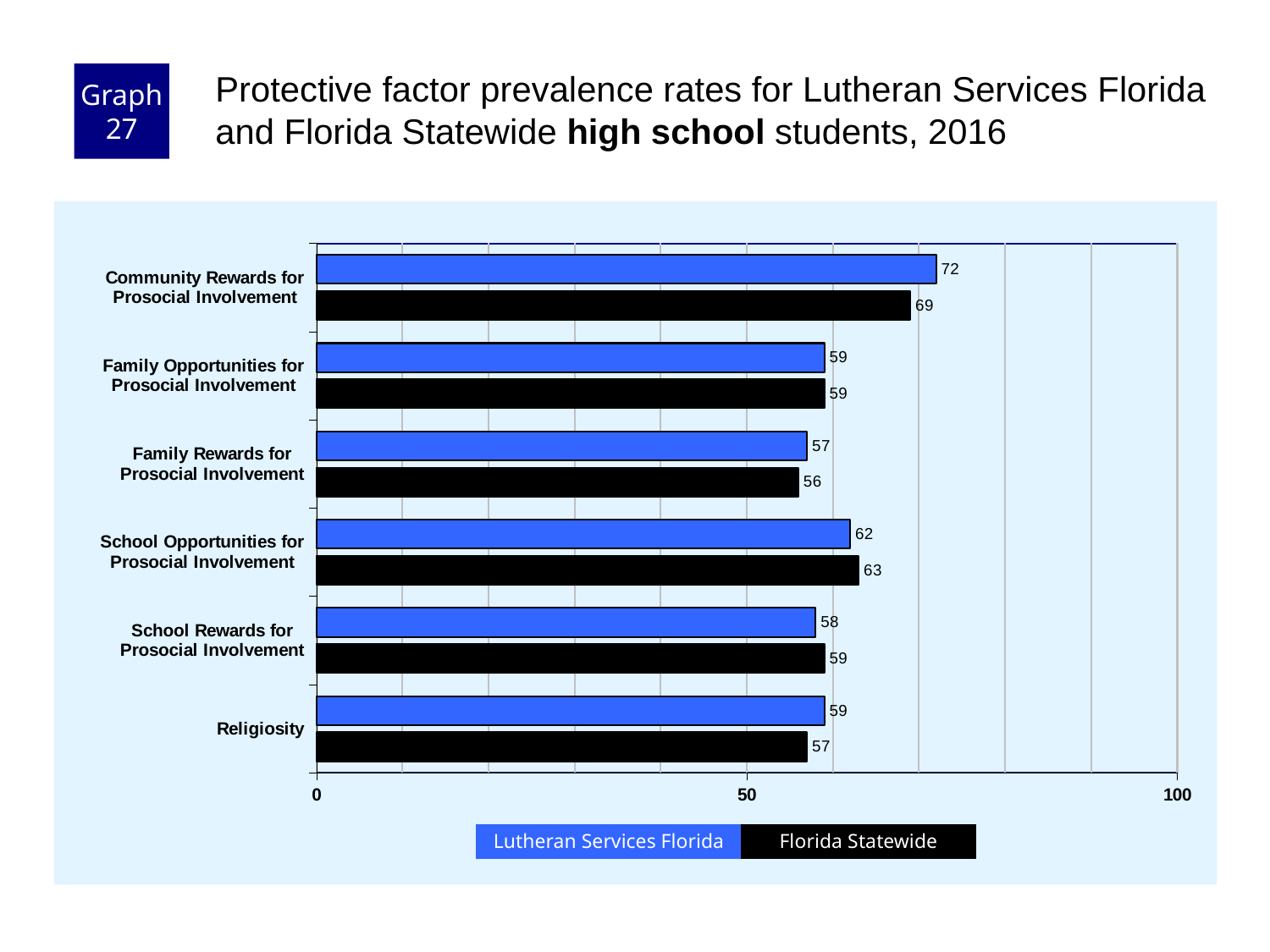
What is the Florida Statewide value for School Opportunities for Prosocial Involvement? 63 Which category has the lowest Florida Statewide value? Family Rewards for Prosocial Involvement What is the difference between the Lutheran Services Florida and Florida Statewide values for Community Rewards for Prosocial Involvement? 3 How many categories are shown on the chart? 6 How many series does the legend list? 2 Which colour represents Florida Statewide in the chart? Black What kind of chart is shown on the slide? Bar chart Is the Florida Statewide value for Community Rewards for Prosocial Involvement greater or less than 50? greater What is the Lutheran Services Florida value for Community Rewards for Prosocial Involvement? 72 Which category has the highest Lutheran Services Florida value? Community Rewards for Prosocial Involvement For School Opportunities for Prosocial Involvement, which is larger: the Lutheran Services Florida value or the Florida Statewide value? Florida Statewide What is the Florida Statewide value for Religiosity? 57